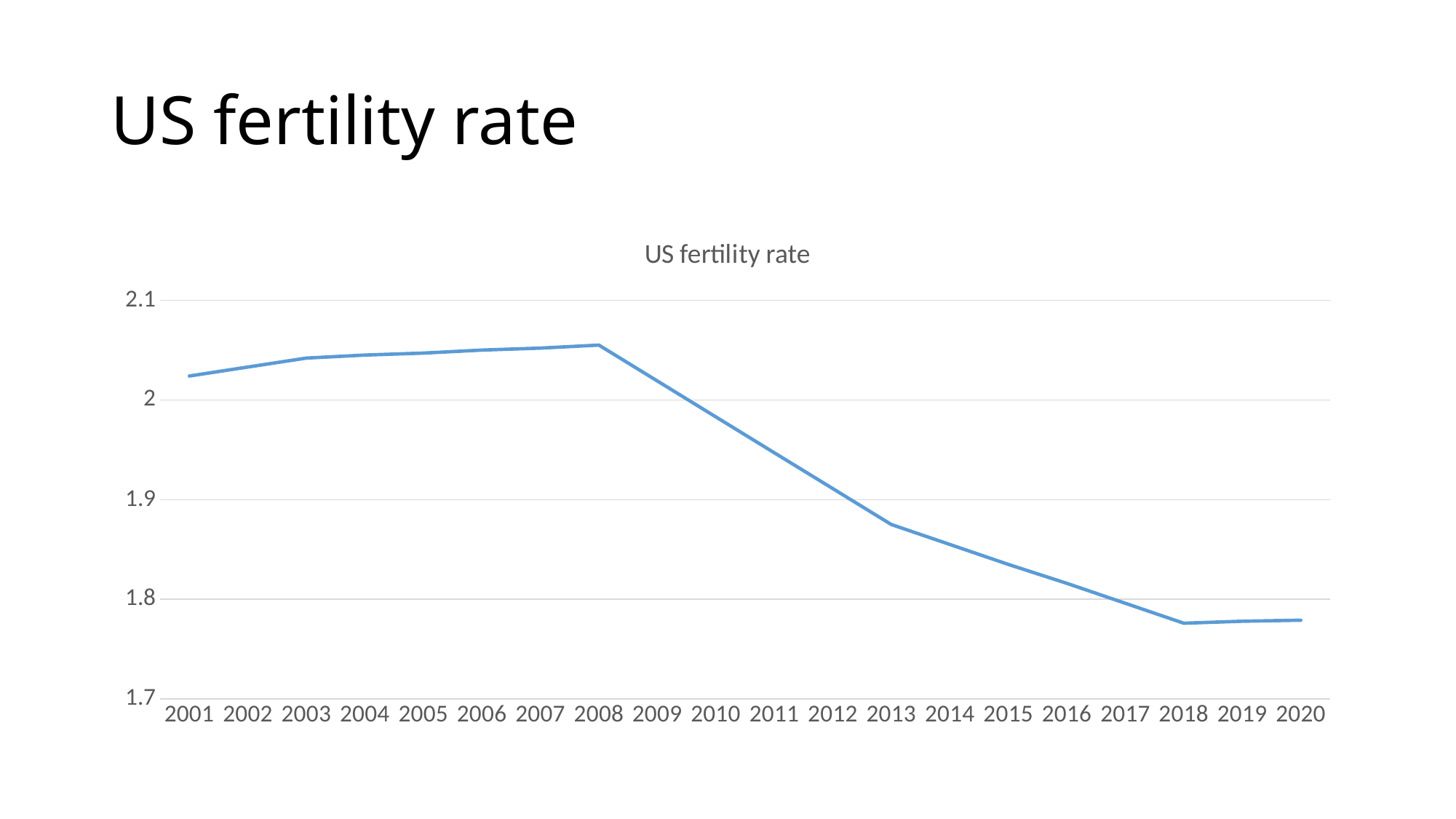
What is the title of the chart? US fertility rate Which year has the highest US fertility rate? 2008 Is the value for 2013 greater or less than 1.9? less Which is larger, the value for 2008 or the value for 2013? 2008 Which is larger, the value for 2003 or the value for 2016? 2003 What kind of chart is shown on the slide? line chart Is the value for 2001 greater or less than 2? greater How many years are plotted along the x axis? 20 Is the value for 2008 greater or less than 2? greater Does the US fertility rate rise or fall between 2008 and 2018? fall